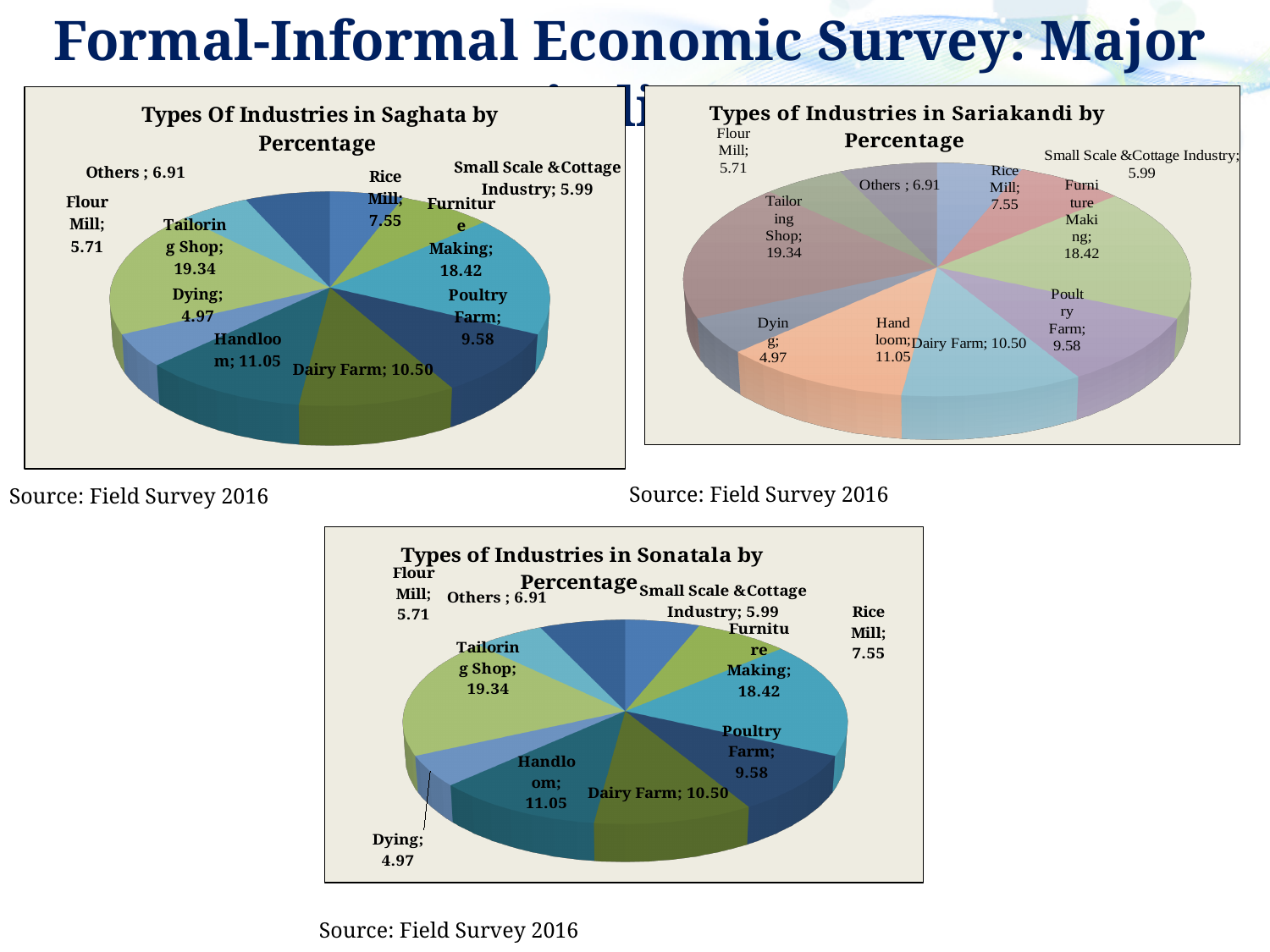
In the 'Types of Industries in Sonatala by Percentage' chart, what is the difference between the values for Tailoring Shop and Furniture Making? 0.92 In the 'Types Of Industries in Saghata by Percentage' chart, what is the difference between the values for Rice Mill and Small Scale & Cottage Industry? 1.56 In the 'Types of Industries in Sariakandi by Percentage' chart, what is the value for Furniture Making? 18.42 In the 'Types of Industries in Sariakandi by Percentage' chart, which category has the smallest share? Dying In the 'Types of Industries in Sonatala by Percentage' chart, what is the value for Dairy Farm? 10.50 In the 'Types of Industries in Sariakandi by Percentage' chart, what is the value for Flour Mill? 5.71 In the 'Types Of Industries in Saghata by Percentage' chart, which is larger: Handloom or Dairy Farm? Handloom How many categories are shown in the 'Types of Industries in Sariakandi by Percentage' chart? 10 What kind of chart is 'Types of Industries in Sonatala by Percentage'? Pie chart In the 'Types Of Industries in Saghata by Percentage' chart, what is the value for Tailoring Shop? 19.34 In the 'Types Of Industries in Saghata by Percentage' chart, which category has the largest share? Tailoring Shop How many pie charts are shown on the slide? 3